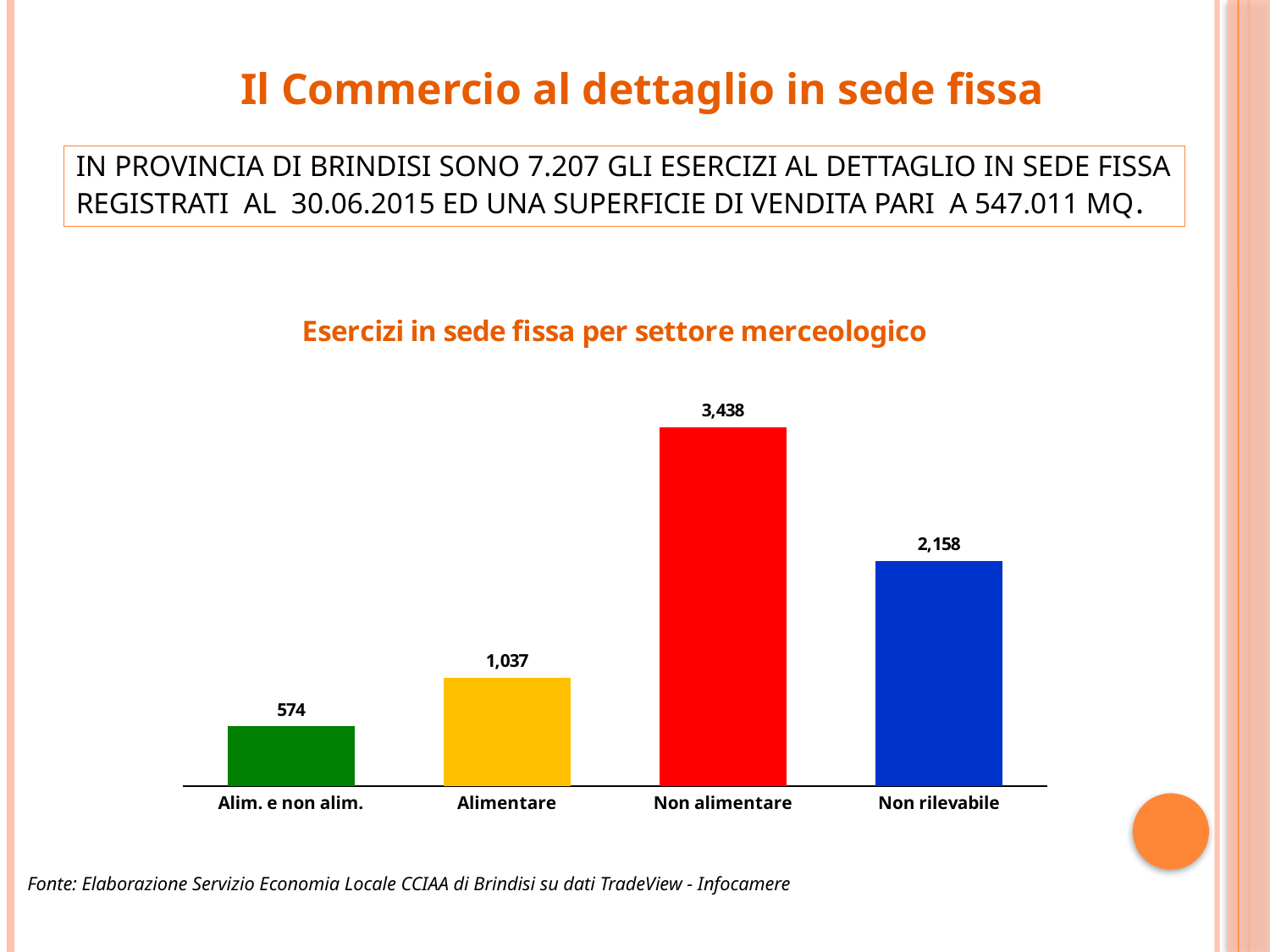
What kind of chart is shown on the slide? Bar chart What is the title of the chart? Esercizi in sede fissa per settore merceologico What is the value for Alim. e non alim.? 574 What is the value for Non alimentare? 3,438 How many categories are shown in the chart? 4 What is the difference between the values for Non alimentare and Non rilevabile? 1,280 Which category has the lowest value? Alim. e non alim. Which is larger, the value for Alimentare or the value for Non rilevabile? Non rilevabile What is the difference between the values for Alimentare and Alim. e non alim.? 463 What is the value for Non rilevabile? 2,158 Which category has the highest value? Non alimentare What is the value for Alimentare? 1,037